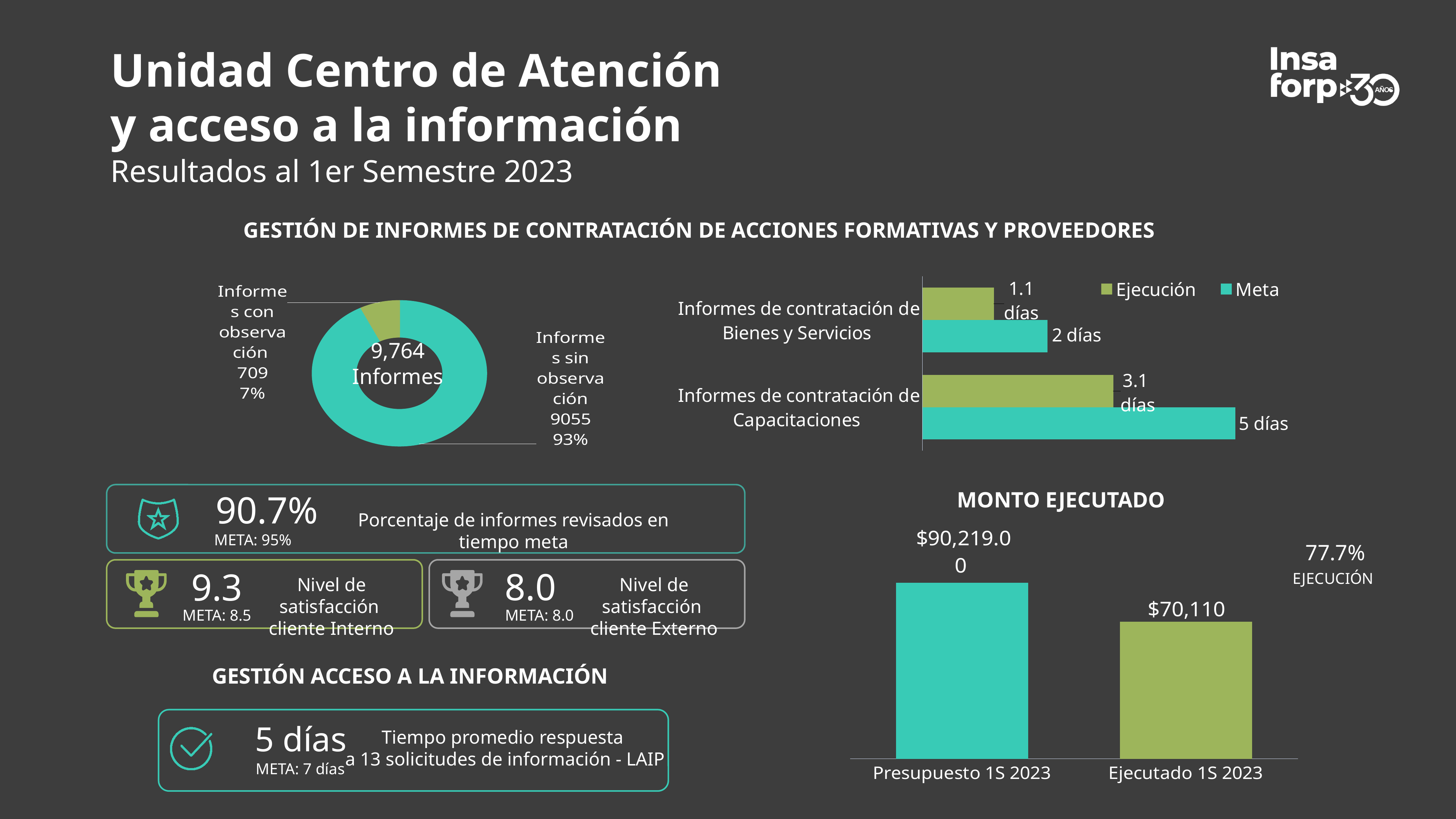
What kind of chart is the 'MONTO EJECUTADO' chart? Bar chart In the horizontal bar chart at the top right, what is the Ejecución value for 'Informes de contratación de Capacitaciones'? 3.1 días In the horizontal bar chart at the top right, which category has the larger Meta value: Bienes y Servicios or Capacitaciones? Informes de contratación de Capacitaciones In the 'MONTO EJECUTADO' chart, what is the value for 'Presupuesto 1S 2023'? $90,219.00 In the horizontal bar chart at the top right, what is the Meta value for 'Informes de contratación de Bienes y Servicios'? 2 días In the 'MONTO EJECUTADO' chart, what is the value for 'Ejecutado 1S 2023'? $70,110 In the doughnut chart on the left, how many informes are labelled 'Informes con observación'? 709 How many slices does the doughnut chart on the left have? 2 In the doughnut chart on the left, what share of the total do 'Informes sin observación' represent? 93% In the horizontal bar chart at the top right, what is the difference between the Meta and the Ejecución for 'Informes de contratación de Capacitaciones'? 1.9 días How many series does the legend of the horizontal bar chart at the top right list? 2 What total number of informes is shown in the centre of the doughnut chart on the left? 9,764 Informes